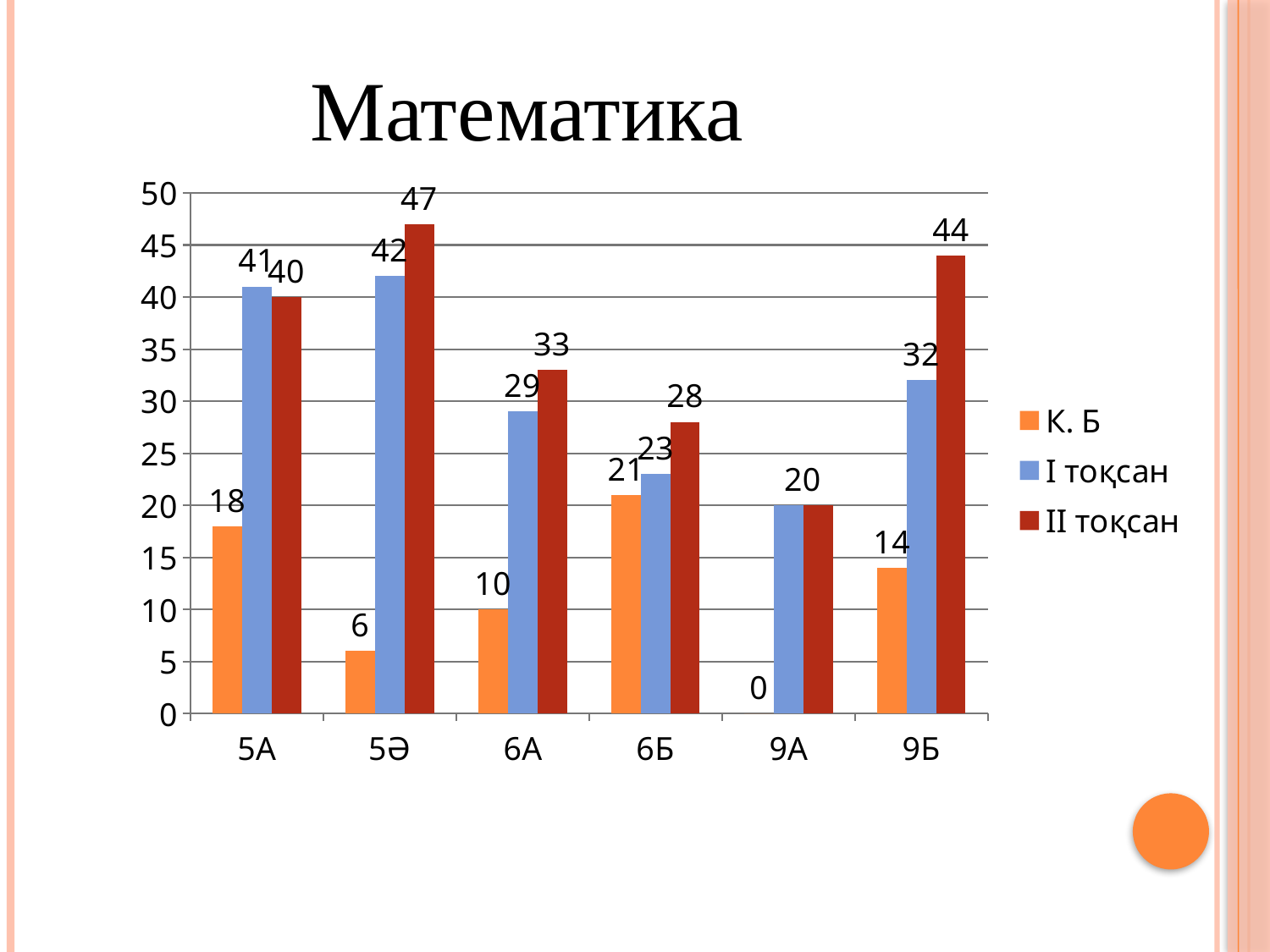
How many series does the legend list? 3 Is the value for I тоқсан in category 9А greater or less than 30? less Which category has the lowest value for К. Б? 9А What type of chart is shown on the slide? bar chart What is the value for К. Б in category 5А? 18 Which is larger in category 6Б: К. Б or I тоқсан? I тоқсан What is the value for I тоқсан in category 6А? 29 What is the value for II тоқсан in category 5Ә? 47 Which category has the highest value for II тоқсан? 5Ә What is the difference between II тоқсан and I тоқсан in category 9Б? 12 How many categories are shown on the x axis? 6 What is the value for К. Б in category 9А? 0